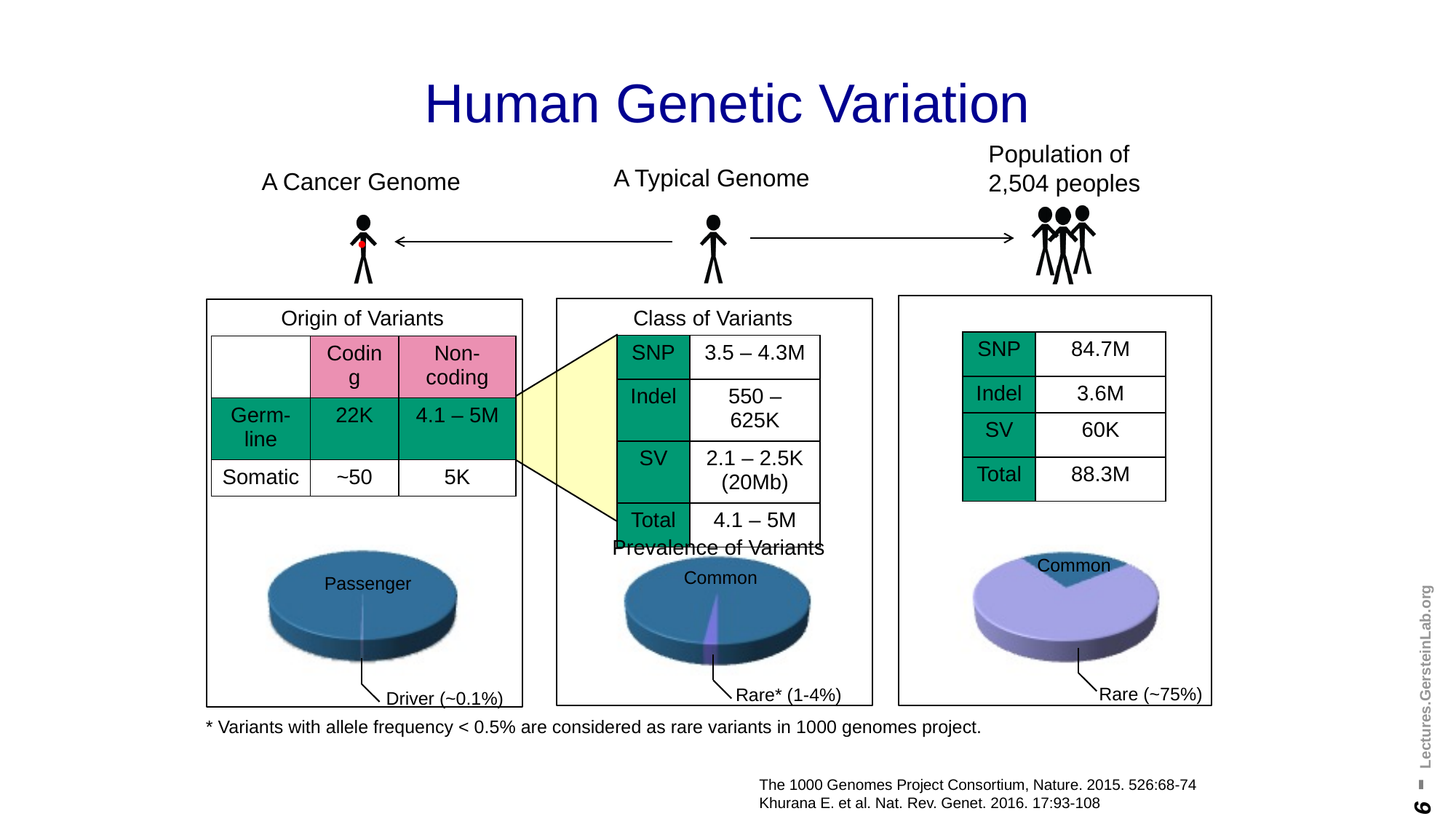
In the 'Prevalence of Variants' pie chart under 'A Typical Genome', which slice is the smallest? Rare In the pie chart under 'A Cancer Genome', which slice is the smallest? Driver What label is attached to the small slice of the pie chart under 'A Cancer Genome'? Driver (~0.1%) In the pie chart under 'A Cancer Genome', how many slices are there? 2 In the pie chart under 'Population of 2,504 peoples', how many slices are there? 2 What kind of chart is shown under 'A Cancer Genome' at the bottom left of the slide? pie chart In the pie chart under 'Population of 2,504 peoples', which slice is larger, Common or Rare? Rare In the pie chart under 'Population of 2,504 peoples', which slice is the largest? Rare What kind of chart is shown under 'Population of 2,504 peoples' at the bottom right of the slide? pie chart In the 'Prevalence of Variants' pie chart under 'A Typical Genome', which slice is larger, Common or Rare? Common In the pie chart under 'A Cancer Genome', which slice is larger, Passenger or Driver? Passenger What is the title printed above the pie chart under 'A Typical Genome'? Prevalence of Variants